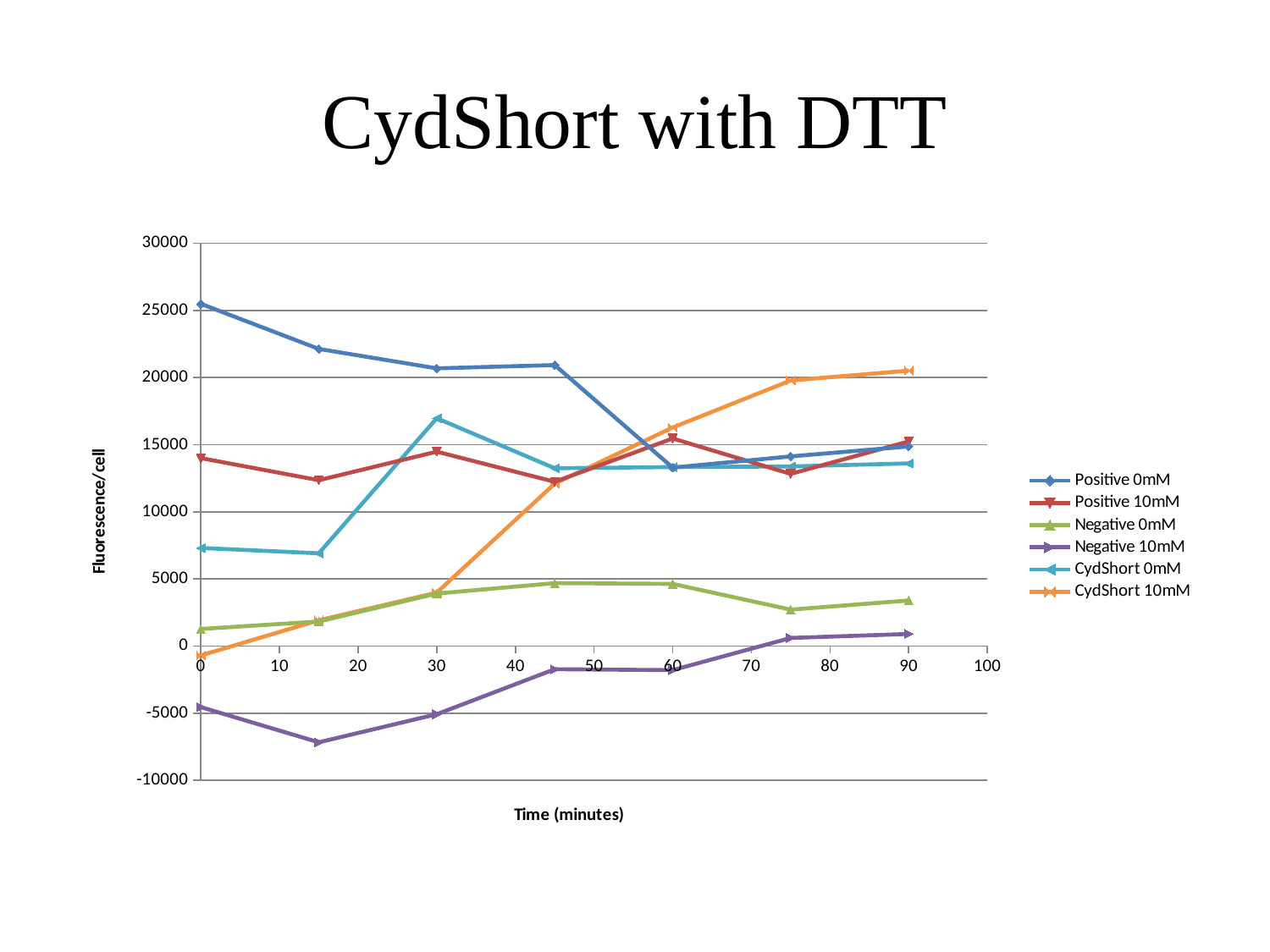
Which series has the lowest value at 0 minutes? Negative 10mM What kind of chart is shown on the slide? line chart How many series does the legend list? 6 Does the CydShort 10mM series rise or fall from 0 to 90 minutes? rise Is the value for CydShort 10mM at 90 minutes greater or less than 20000? greater Which series has the highest value at 90 minutes? CydShort 10mM Which series has the highest value at 0 minutes? Positive 0mM Is the value for CydShort 0mM at 30 minutes greater or less than 15000? greater Is the value for Positive 0mM at 0 minutes greater or less than 25000? greater How many time points are plotted for each series? 7 At 30 minutes, which is larger: CydShort 0mM or Positive 10mM? CydShort 0mM